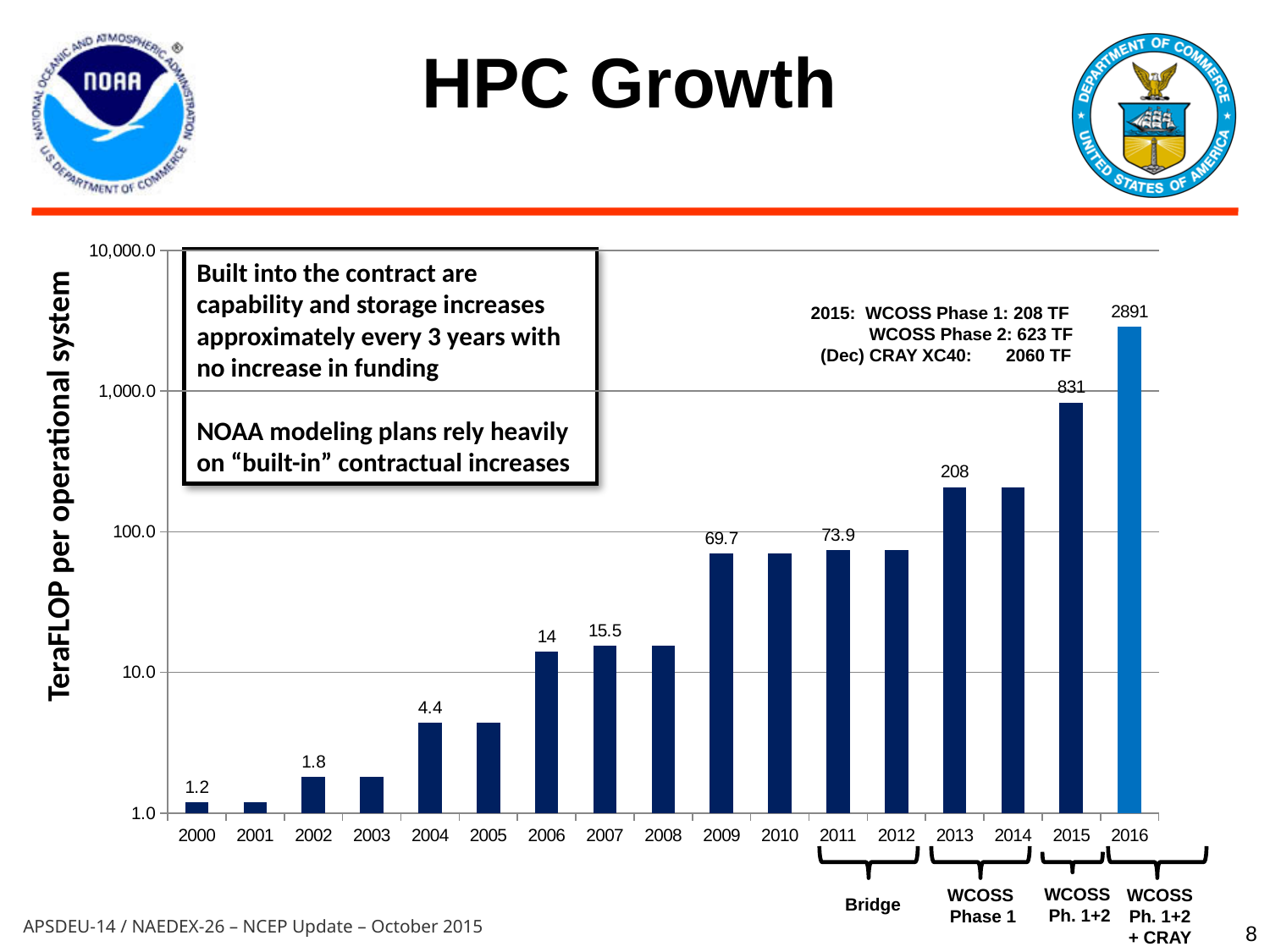
What is the title of the y axis? TeraFLOP per operational system What is the value for 2009? 69.7 What is the value for 2004? 4.4 Which year has the lowest value? 2000 and 2001 What is the difference between the values for 2007 and 2006? 1.5 Which is larger, the value for 2013 or the value for 2011? 2013 What is the value for 2016? 2891 What kind of chart is shown on the slide? Bar chart Is the value for 2014 greater or less than 100.0? greater Which year has the highest value? 2016 How many years are shown on the x axis? 17 What is the difference between the values for 2016 and 2015? 2060